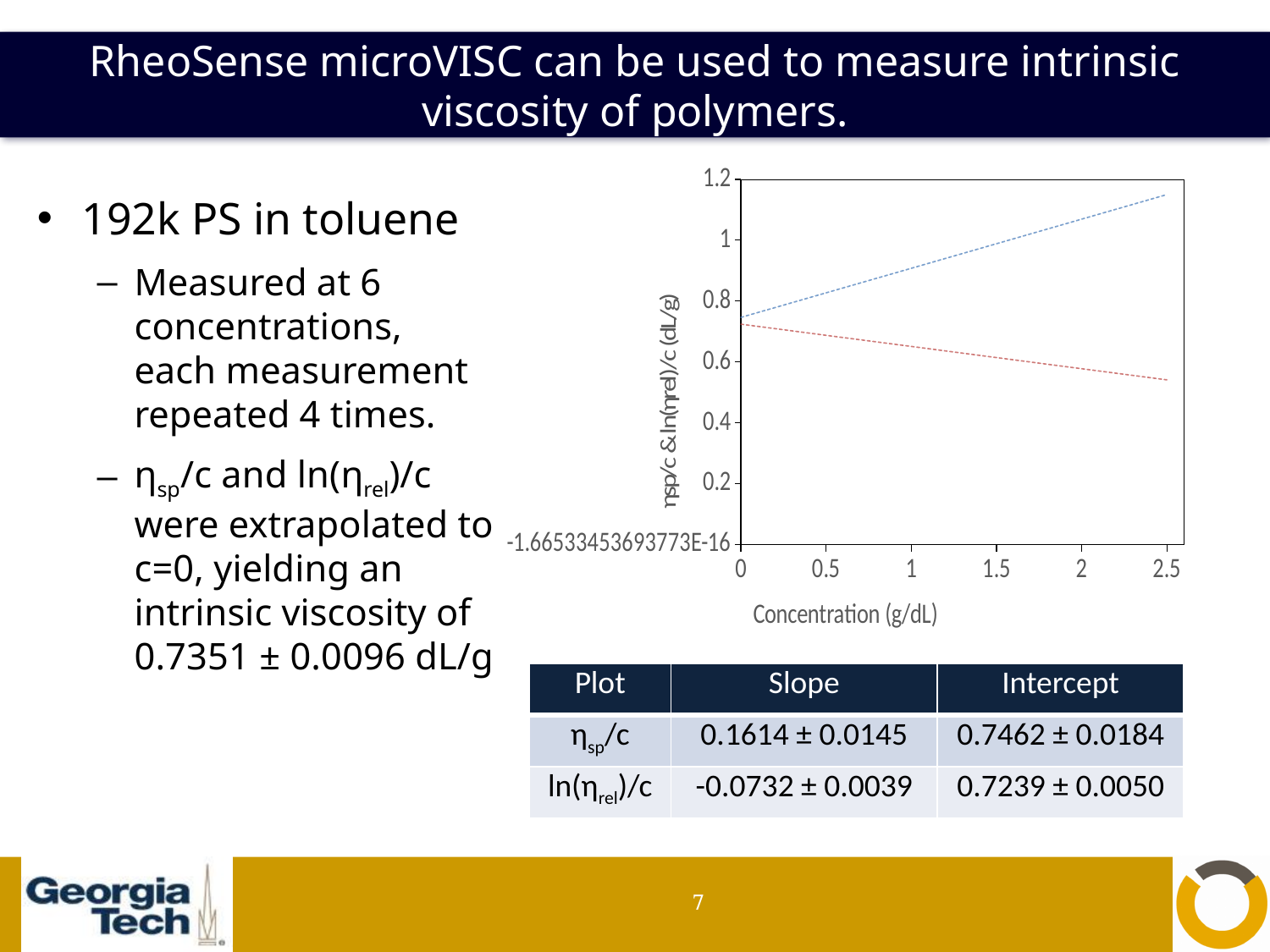
At a concentration of 0, are both lines greater or less than 0.6? greater At a concentration of 2.5 g/dL, is the blue dashed line greater or less than 1? greater At a concentration of 2.5 g/dL, which line is higher, the blue dashed line or the red dashed line? blue dashed line Does the blue dashed line rise or fall as concentration increases? rise What kind of chart is shown on the slide? line chart What is the highest value shown on the y axis of the chart? 1.2 Does the red dashed line rise or fall as concentration increases? fall What is the label of the x axis of the chart? Concentration (g/dL) How many lines are plotted on the chart? 2 At a concentration of 2.5 g/dL, is the red dashed line greater or less than 0.6? less